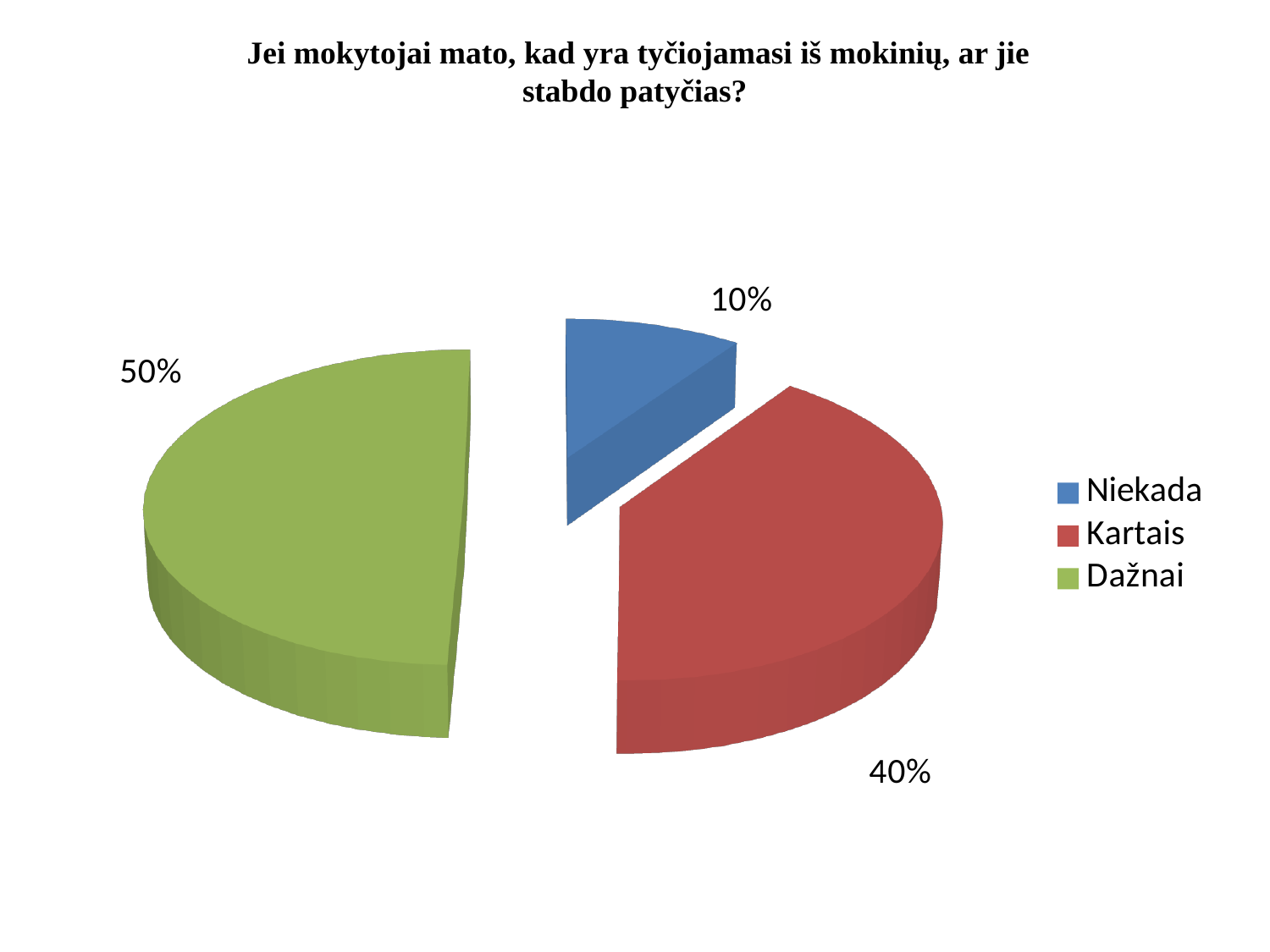
Which category has the smallest share of the pie? Niekada What colour is the Dažnai slice? Green What percentage of the pie is labelled Niekada? 10% How many slices does the pie chart have? 3 What is the title of the chart? Jei mokytojai mato, kad yra tyčiojamasi iš mokinių, ar jie stabdo patyčias? What percentage of the pie is labelled Dažnai? 50% Which is larger, the Kartais slice or the Niekada slice? Kartais Which category has the largest share of the pie? Dažnai What kind of chart is shown on the slide? Pie chart What is the difference in percentage points between the Kartais and Niekada slices? 30 What percentage of the pie is labelled Kartais? 40% What is the difference in percentage points between the Dažnai and Kartais slices? 10